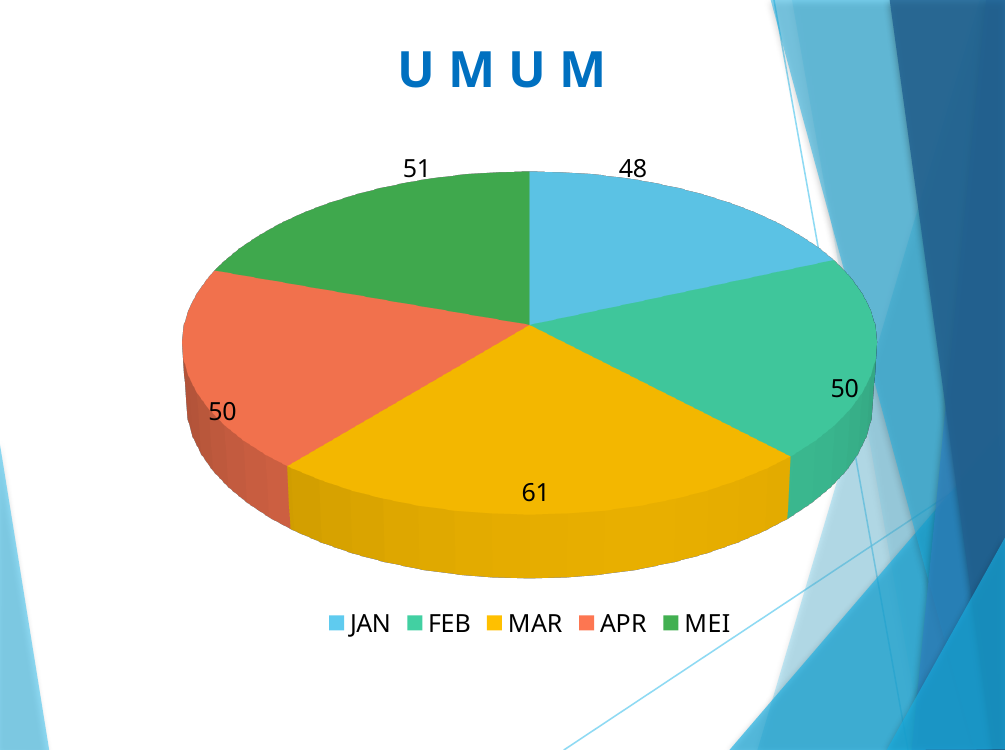
How many slices does the pie chart have? 5 What is the value for APR? 50 What is the difference between the values for MAR and JAN? 13 What is the value for MEI? 51 What is the value for JAN? 48 Which category has the largest slice? MAR Which is larger, the value for MAR or the value for FEB? MAR Which category has the smallest slice? JAN What kind of chart is shown on the slide? pie chart How many entries does the legend list? 5 What is the value for MAR? 61 What is the title of the chart? U M U M